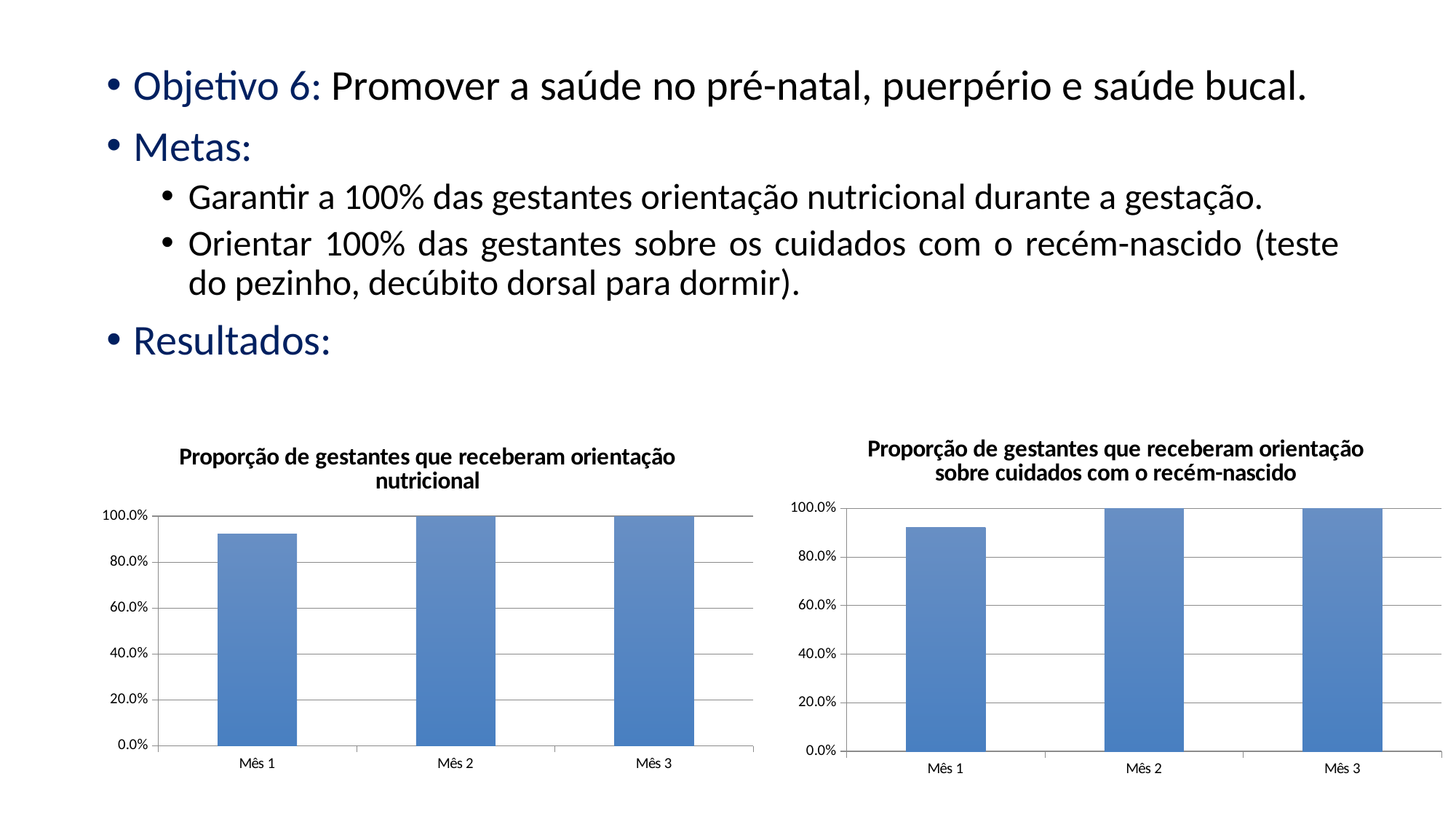
In the left chart (orientação nutricional), which is larger, the value for Mês 1 or the value for Mês 2? Mês 2 In the left chart (orientação nutricional), is the value for Mês 1 greater or less than 80.0%? greater In the chart titled 'Proporção de gestantes que receberam orientação sobre cuidados com o recém-nascido', what is the value for Mês 3? 100.0% What kind of chart is the right chart (cuidados com o recém-nascido)? bar chart In the left chart (orientação nutricional), which month has the lowest value? Mês 1 What is the title of the right chart on the slide? Proporção de gestantes que receberam orientação sobre cuidados com o recém-nascido In the right chart (cuidados com o recém-nascido), is the value for Mês 1 greater or less than 100.0%? less In the left chart (orientação nutricional), does the value rise or fall from Mês 1 to Mês 2? rise How many months are shown on the x axis of the left chart (orientação nutricional)? 3 In the right chart (cuidados com o recém-nascido), which month has the lowest value? Mês 1 In the chart titled 'Proporção de gestantes que receberam orientação nutricional', what is the value for Mês 2? 100.0% In the right chart (cuidados com o recém-nascido), which is larger, the value for Mês 3 or the value for Mês 1? Mês 3